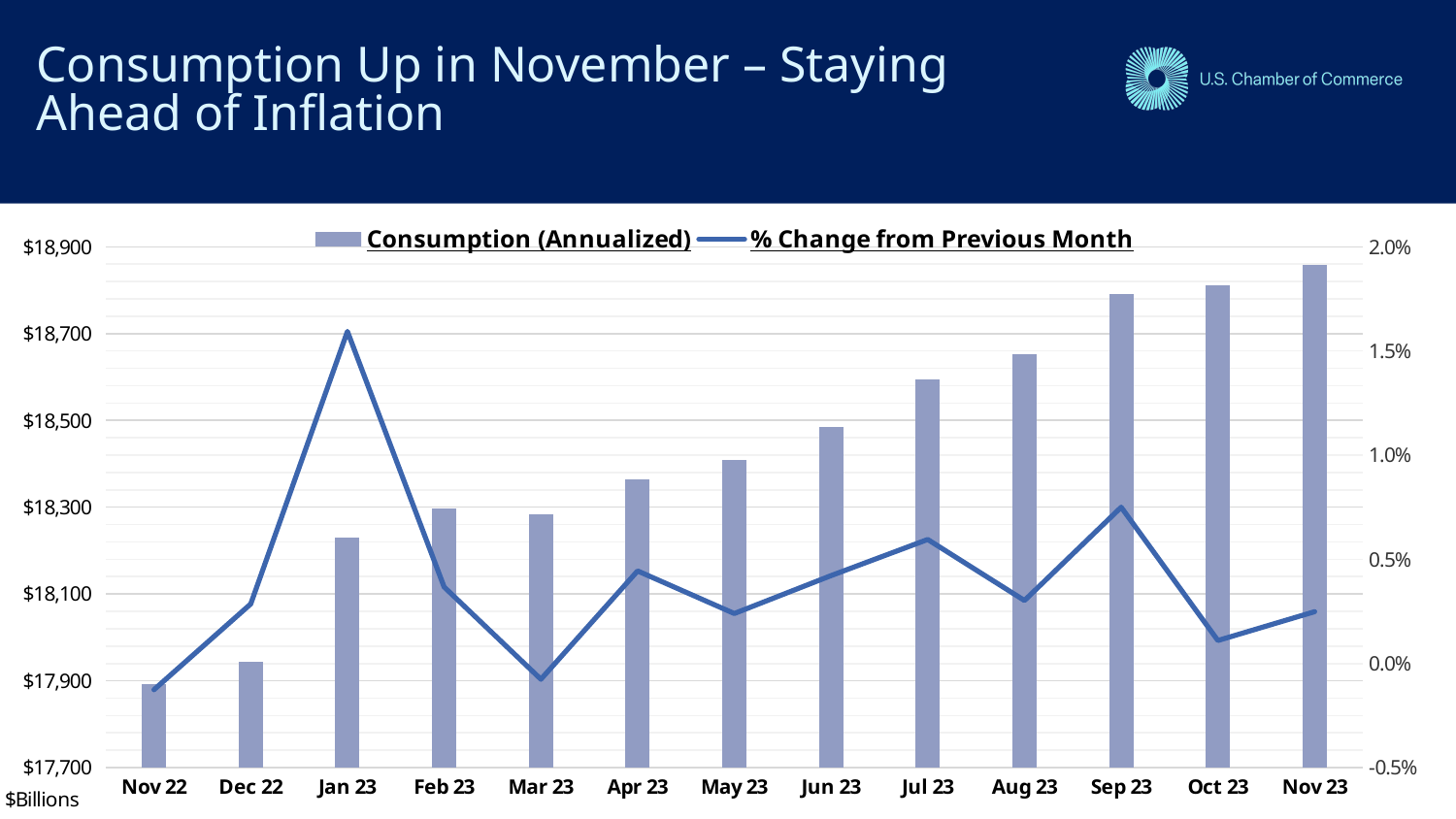
Is the % Change from Previous Month for Oct 23 greater or less than 0.5%? less Which month has the highest % Change from Previous Month? Jan 23 Do the Consumption (Annualized) bars generally rise or fall from Nov 22 to Nov 23? Rise What type of chart is shown on the slide? Combination bar and line chart How many months are shown on the x axis? 13 Is the Consumption (Annualized) value for Jan 23 greater or less than $18,300? less Is the % Change from Previous Month for Jan 23 greater or less than 1.0%? greater Which month has the highest Consumption (Annualized) bar? Nov 23 Which month has the lowest Consumption (Annualized) bar? Nov 22 Which month has the larger Consumption (Annualized) bar, Jun 23 or Jul 23? Jul 23 How many series does the legend list? 2